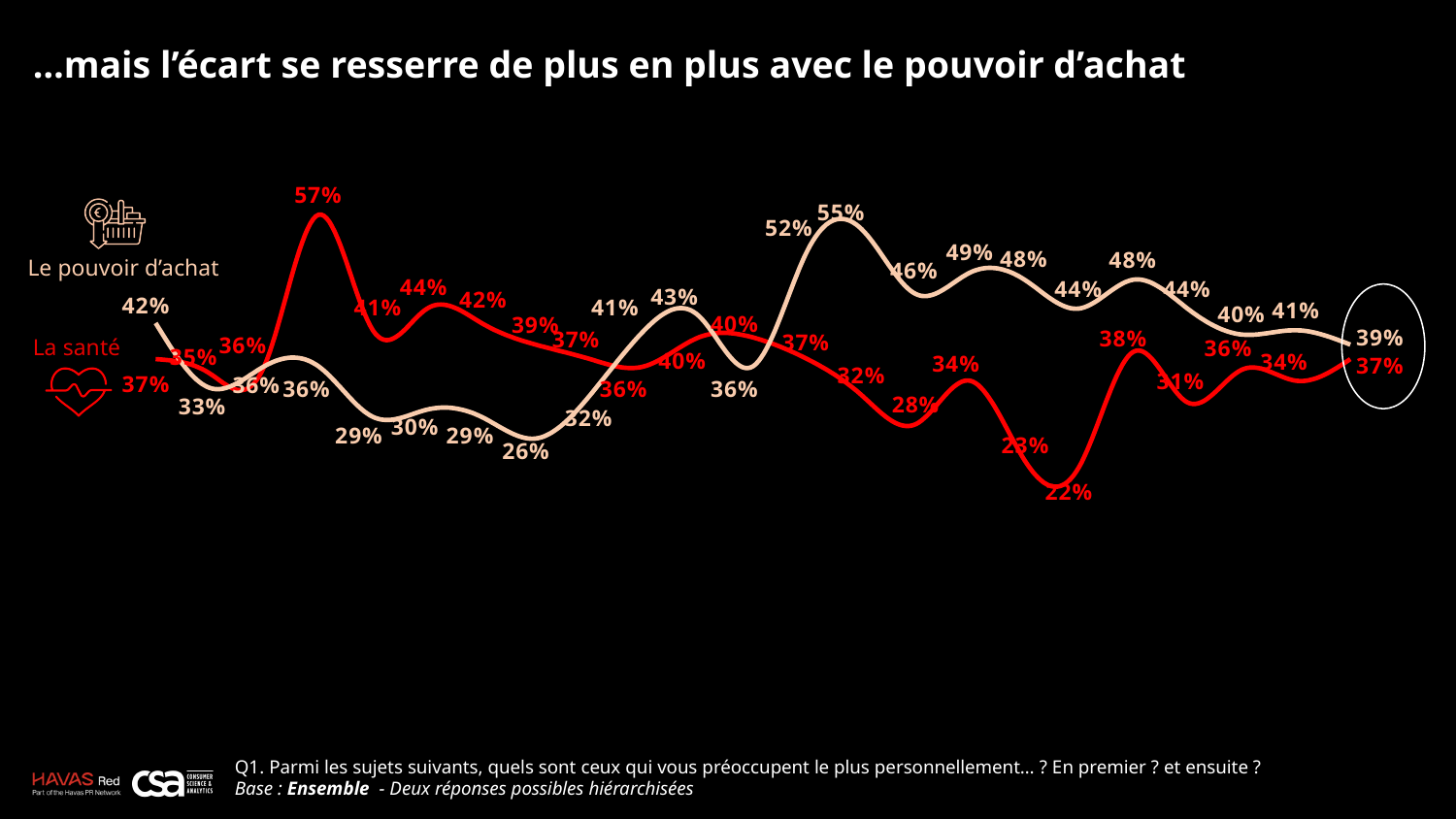
At the last point on the chart, which series has the higher value, 'Le pouvoir d'achat' or 'La santé'? Le pouvoir d'achat How many series does the chart show? 2 What is the final (rightmost, circled) value of the 'Le pouvoir d'achat' series? 39% What kind of chart is shown on the slide? Line chart What is the final (rightmost, circled) value of the 'La santé' series? 37% What is the title of the slide? …mais l'écart se resserre de plus en plus avec le pouvoir d'achat What is the lowest value reached by the 'La santé' series? 22% What is the lowest value reached by the 'Le pouvoir d'achat' series? 26% What is the difference in percentage points between the highest (57%) and lowest (22%) values of the 'La santé' series? 35 percentage points What is the difference in percentage points between the final values of 'Le pouvoir d'achat' (39%) and 'La santé' (37%)? 2 percentage points What is the highest value reached by the 'La santé' series? 57% What is the highest value reached by the 'Le pouvoir d'achat' series? 55%